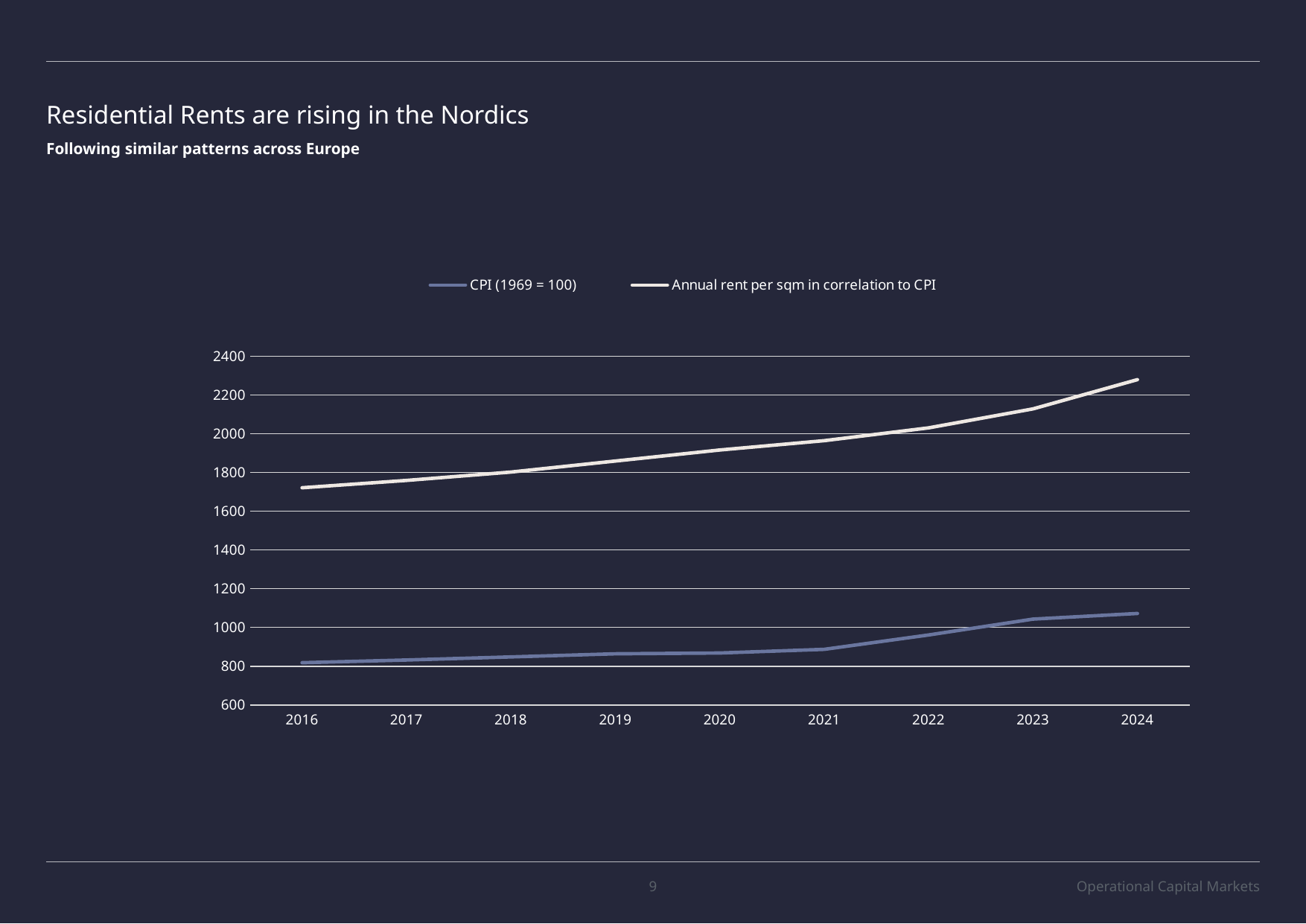
In 2024, which series has the larger value: 'CPI (1969 = 100)' or 'Annual rent per sqm in correlation to CPI'? Annual rent per sqm in correlation to CPI How many years are plotted along the x axis? 9 How many series does the legend list? 2 Does the 'Annual rent per sqm in correlation to CPI' line rise or fall from 2016 to 2024? rise Does the 'CPI (1969 = 100)' line rise or fall from 2016 to 2024? rise Is the value for 'Annual rent per sqm in correlation to CPI' in 2016 greater or less than 1800? less Is the value for 'CPI (1969 = 100)' in 2024 greater or less than 1000? greater Is the value for 'Annual rent per sqm in correlation to CPI' in 2024 greater or less than 2200? greater What kind of chart is shown on the slide? line chart In which year is the 'Annual rent per sqm in correlation to CPI' line at its highest? 2024 What is the title of the slide containing the chart? Residential Rents are rising in the Nordics